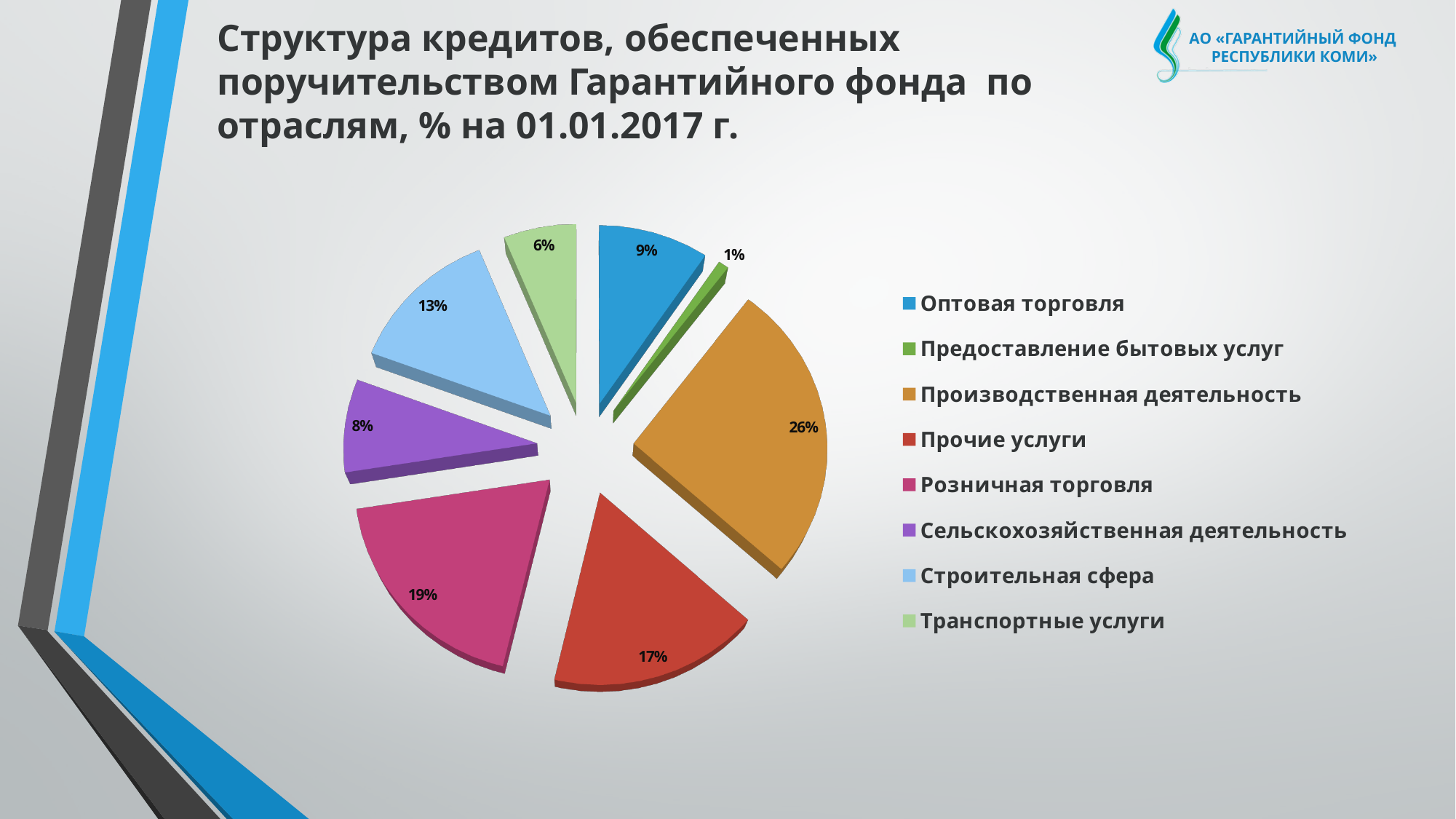
What is the value shown for Строительная сфера? 13% What is the value shown for Предоставление бытовых услуг? 1% What is the difference between the shares of Розничная торговля and Прочие услуги? 2% How many categories does the pie chart have? 8 What share of the pie does Производственная деятельность have? 26% What kind of chart is shown on the slide? Pie chart Which colour represents Прочие услуги in the pie chart? Red What is the value shown for Розничная торговля? 19% Which is larger, the share for Оптовая торговля or the share for Сельскохозяйственная деятельность? Оптовая торговля Which category has the smallest share of the pie? Предоставление бытовых услуг Which category has the largest share of the pie? Производственная деятельность What is the difference between the shares of Строительная сфера and Транспортные услуги? 7%